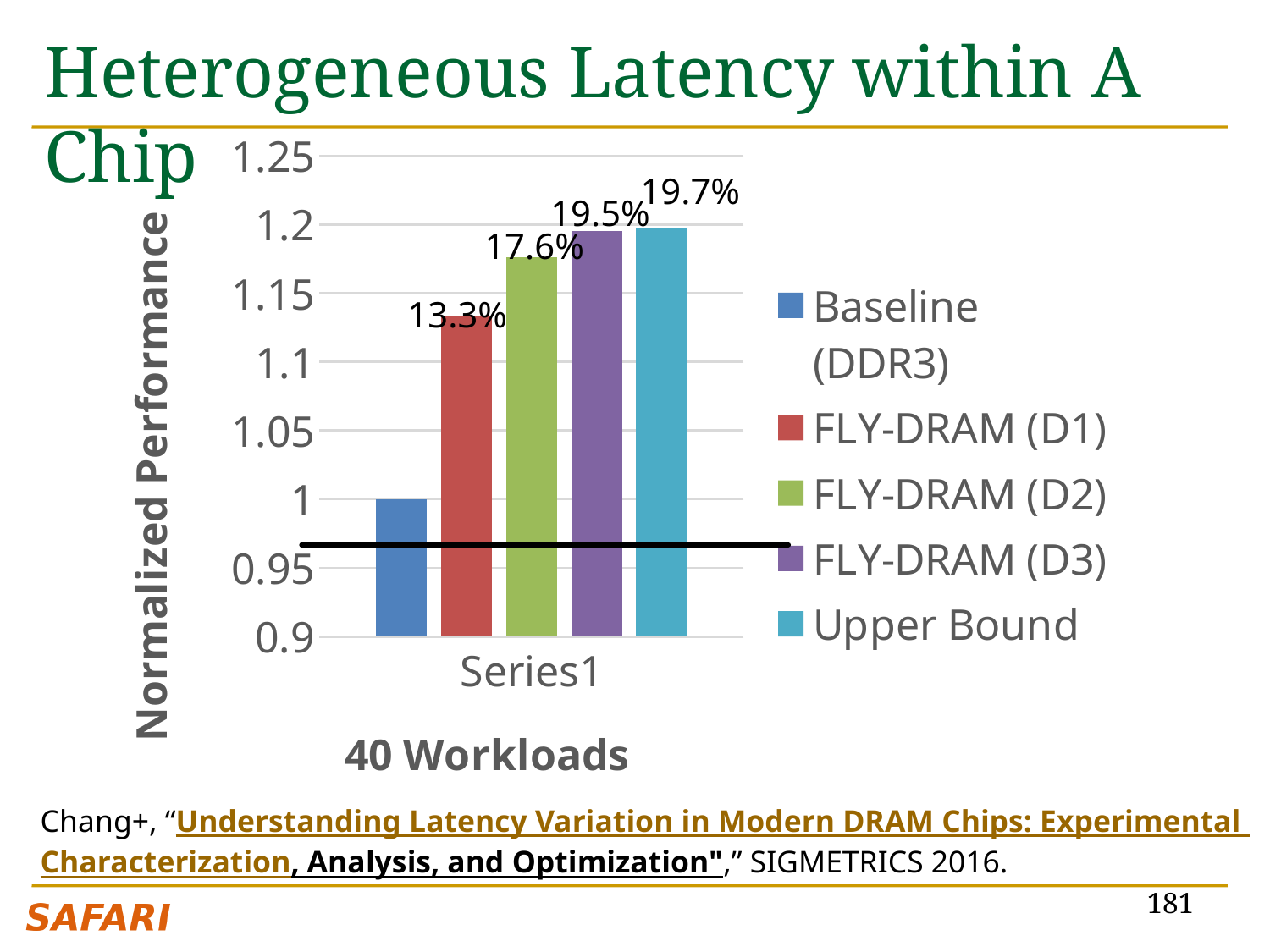
Is the normalized performance for FLY-DRAM (D1) greater or less than 1.15? less What is the normalized performance of the Baseline (DDR3) bar? 1 What data label is shown on the FLY-DRAM (D2) bar? 17.6% What data label is shown on the FLY-DRAM (D3) bar? 19.5% What data label is shown on the FLY-DRAM (D1) bar? 13.3% Which series has the highest normalized performance? Upper Bound Which has a larger improvement label, FLY-DRAM (D2) or FLY-DRAM (D1)? FLY-DRAM (D2) Which series has the lowest normalized performance? Baseline (DDR3) How many series does the legend list? 5 What is the title of the vertical axis? Normalized Performance What data label is shown on the Upper Bound bar? 19.7% What kind of chart is shown on the slide? Bar chart